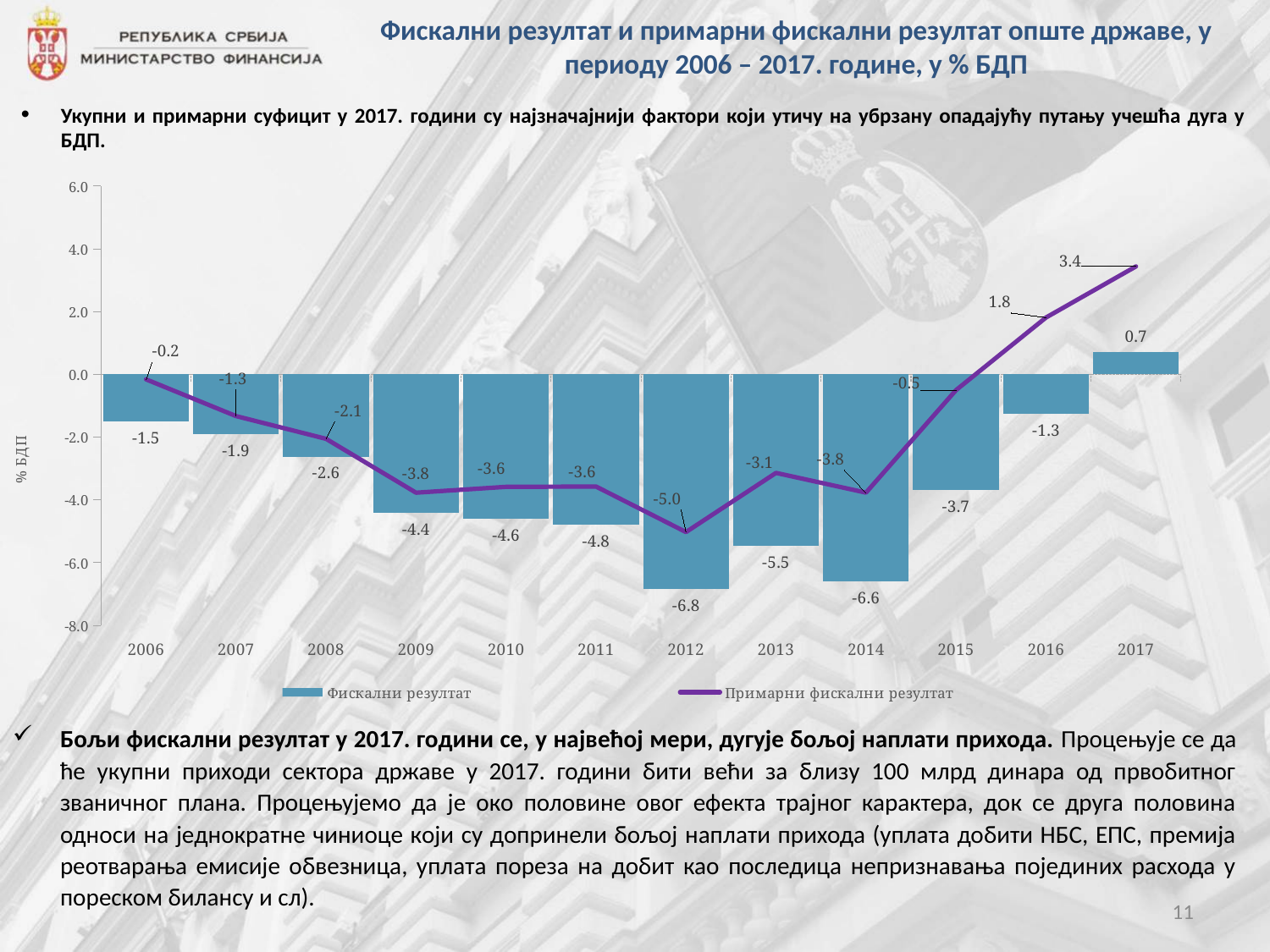
Does Примарни фискални резултат rise or fall from 2014 to 2017? Rise What is the difference between Примарни фискални резултат and Фискални резултат in 2014? 2.8 In which year is Фискални резултат the highest? 2017 What kind of chart is shown on the slide? Combined bar and line chart Which is larger, Фискални резултат in 2013 or in 2014? 2013 How many years are shown on the x axis? 12 What is the value of Примарни фискални резултат for 2017? 3.4 What is the value of Фискални резултат for 2012? -6.8 In which year is Фискални резултат the lowest? 2012 What is the value of Фискални резултат for 2015? -3.7 What is the value of Примарни фискални резултат for 2006? -0.2 How many series does the legend list? 2